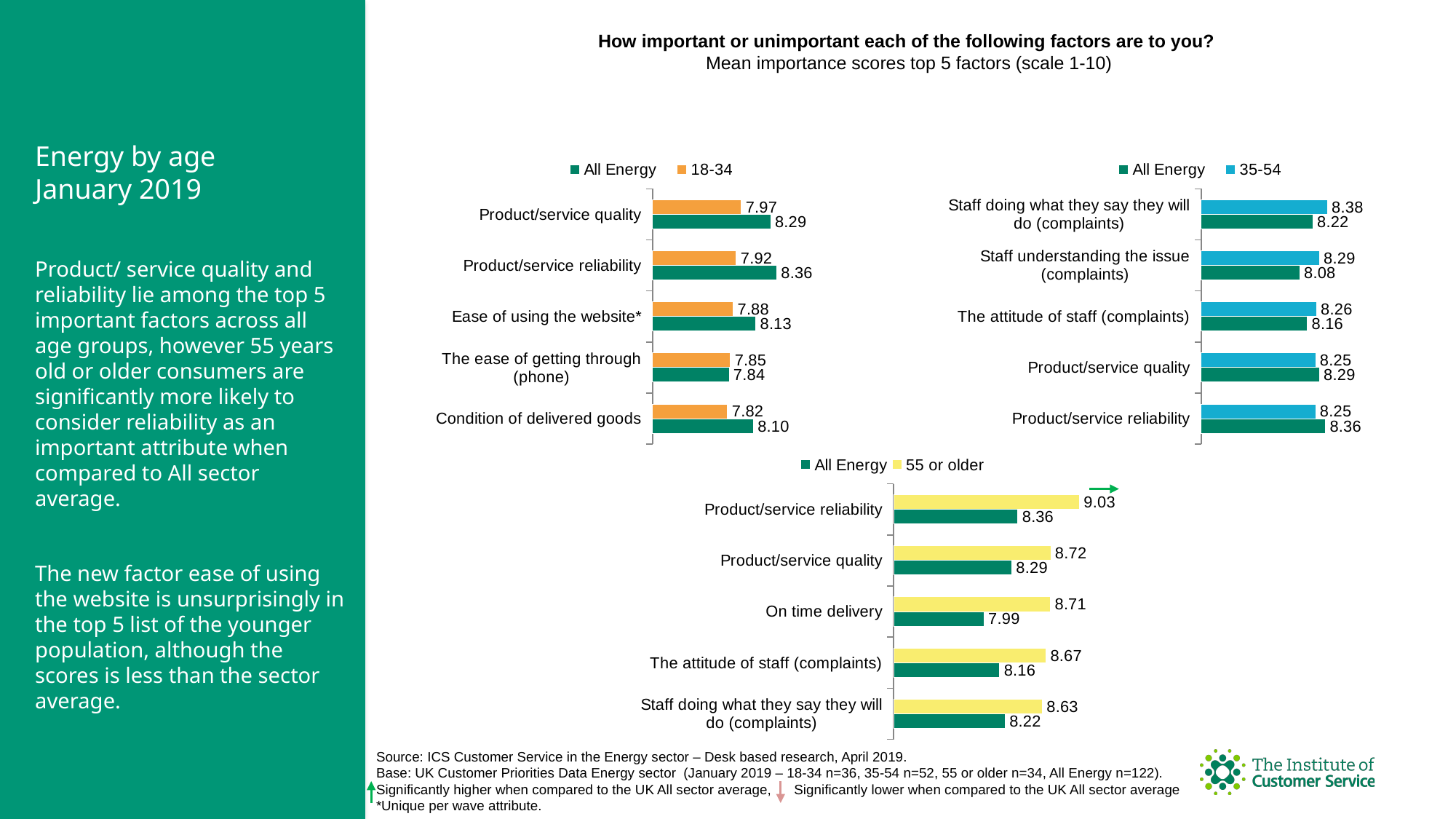
In the top-left chart (All Energy vs 18-34), what is the 18-34 score for Product/service quality? 7.97 In the top-left chart (All Energy vs 18-34), what is the difference between the All Energy and 18-34 scores for Product/service reliability? 0.44 In the bottom chart (All Energy vs 55 or older), which factor has the lowest 55 or older score? Staff doing what they say they will do (complaints) In the top-right chart (All Energy vs 35-54), what is the 35-54 score for Staff understanding the issue (complaints)? 8.29 What type of chart is used for the top-left chart (All Energy vs 18-34)? Bar chart In the top-left chart (All Energy vs 18-34), which factor has the lowest 18-34 score? Condition of delivered goods In the top-right chart (All Energy vs 35-54), is the 35-54 score or the All Energy score higher for Product/service reliability? All Energy In the bottom chart (All Energy vs 55 or older), what is the difference between the 55 or older and All Energy scores for On time delivery? 0.72 In the top-left chart (All Energy vs 18-34), what is the All Energy score for Product/service reliability? 8.36 In the top-right chart (All Energy vs 35-54), which factor has the highest 35-54 score? Staff doing what they say they will do (complaints) In the bottom chart (All Energy vs 55 or older), what is the 55 or older score for Product/service reliability? 9.03 How many factors are shown in the bottom chart (All Energy vs 55 or older)? 5